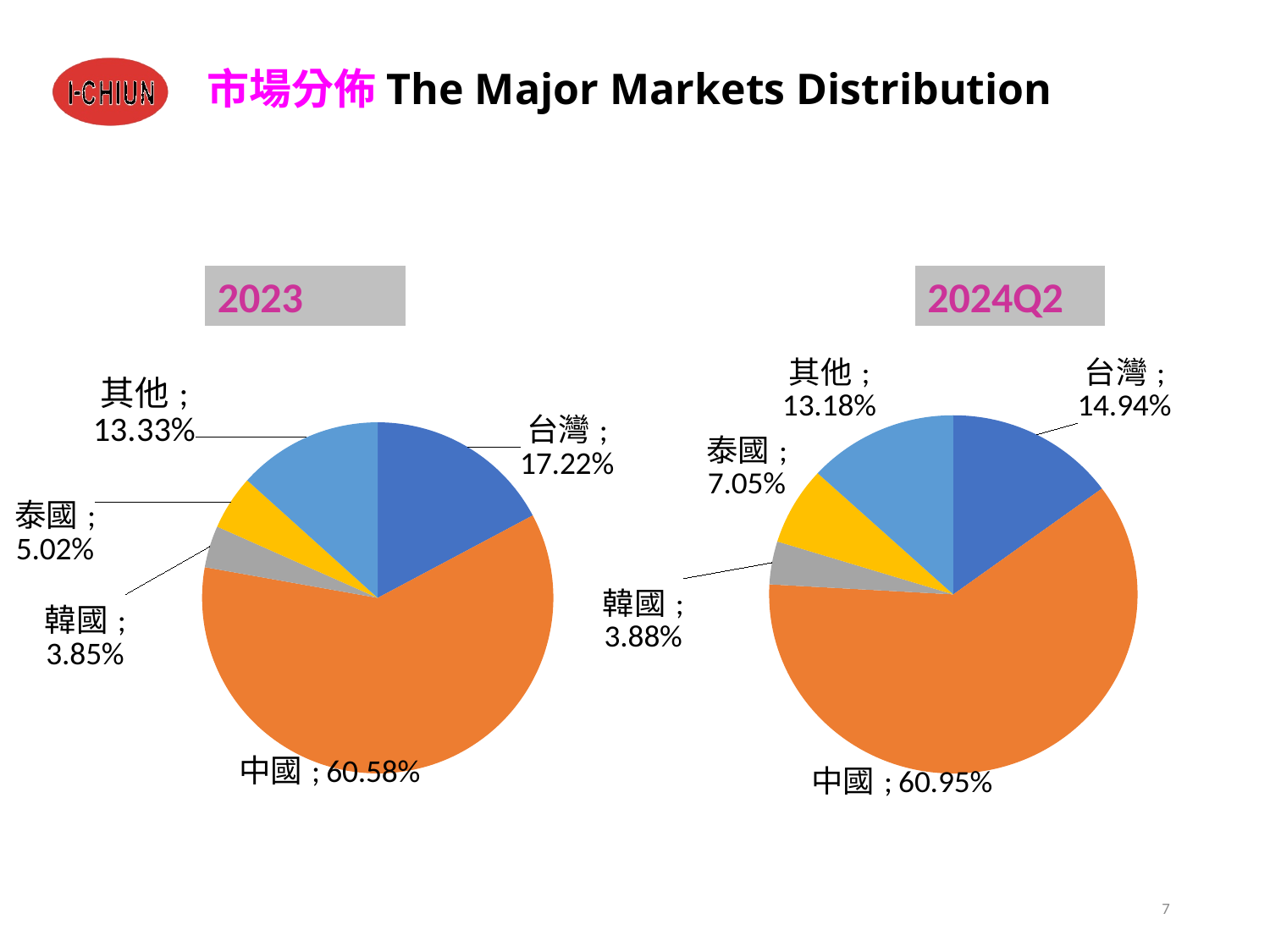
In the 2024Q2 pie chart, what is the value for 韓國? 3.88% In the 2024Q2 pie chart, what share does 台灣 have? 14.94% In the 2024Q2 pie chart, what is the difference between the shares of 泰國 and 韓國? 3.17% In the 2023 pie chart, what is the difference between the shares of 台灣 and 其他? 3.89% In the 2024Q2 pie chart, which category has the smallest share? 韓國 In the 2023 pie chart, which category has the largest share? 中國 Which is larger: the share of 泰國 in the 2023 chart or in the 2024Q2 chart? 2024Q2 How many slices does the 2023 pie chart have? 5 In the 2023 pie chart, what is the value for 泰國? 5.02% In the 2023 pie chart, what share does 中國 have? 60.58% What colour is the 中國 slice in both pie charts? Orange What type of chart is used for the 2024Q2 data? Pie chart